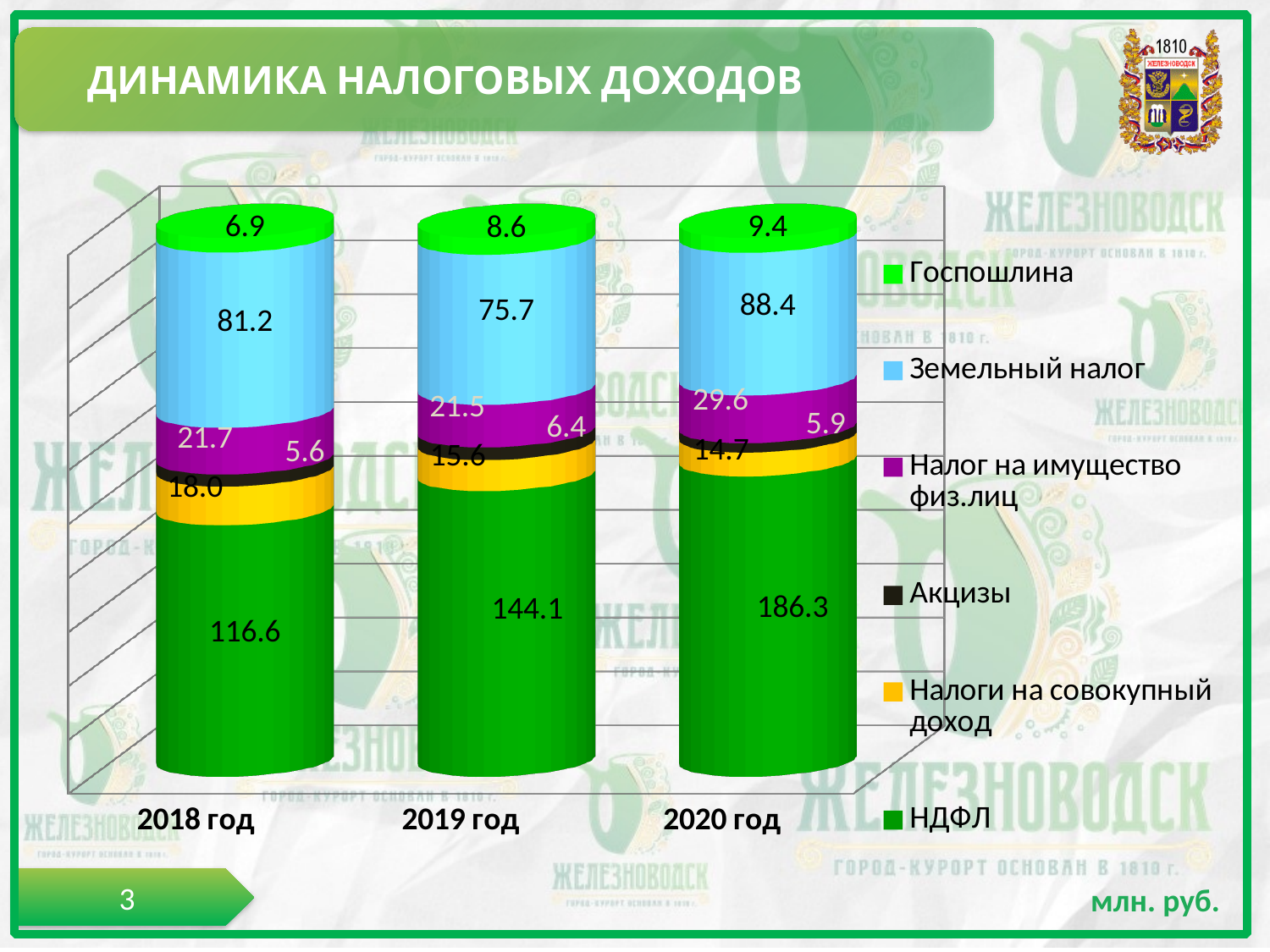
How many years are shown on the x axis? 3 How many series does the legend list? 6 What is the value of Земельный налог for 2019 год? 75.7 How does НДФЛ change from 2018 год to 2020 год? It rises What is the value of Госпошлина for 2018 год? 6.9 In which year is НДФЛ the highest? 2020 год What is the value of Налог на имущество физ.лиц for 2020 год? 29.6 What is the value of НДФЛ for 2020 год? 186.3 Which is larger: Земельный налог in 2018 год or in 2019 год? 2018 год In which year is Налоги на совокупный доход the lowest? 2020 год What is the difference between НДФЛ in 2020 год and 2019 год? 42.2 What kind of chart is shown on the slide? Stacked bar chart